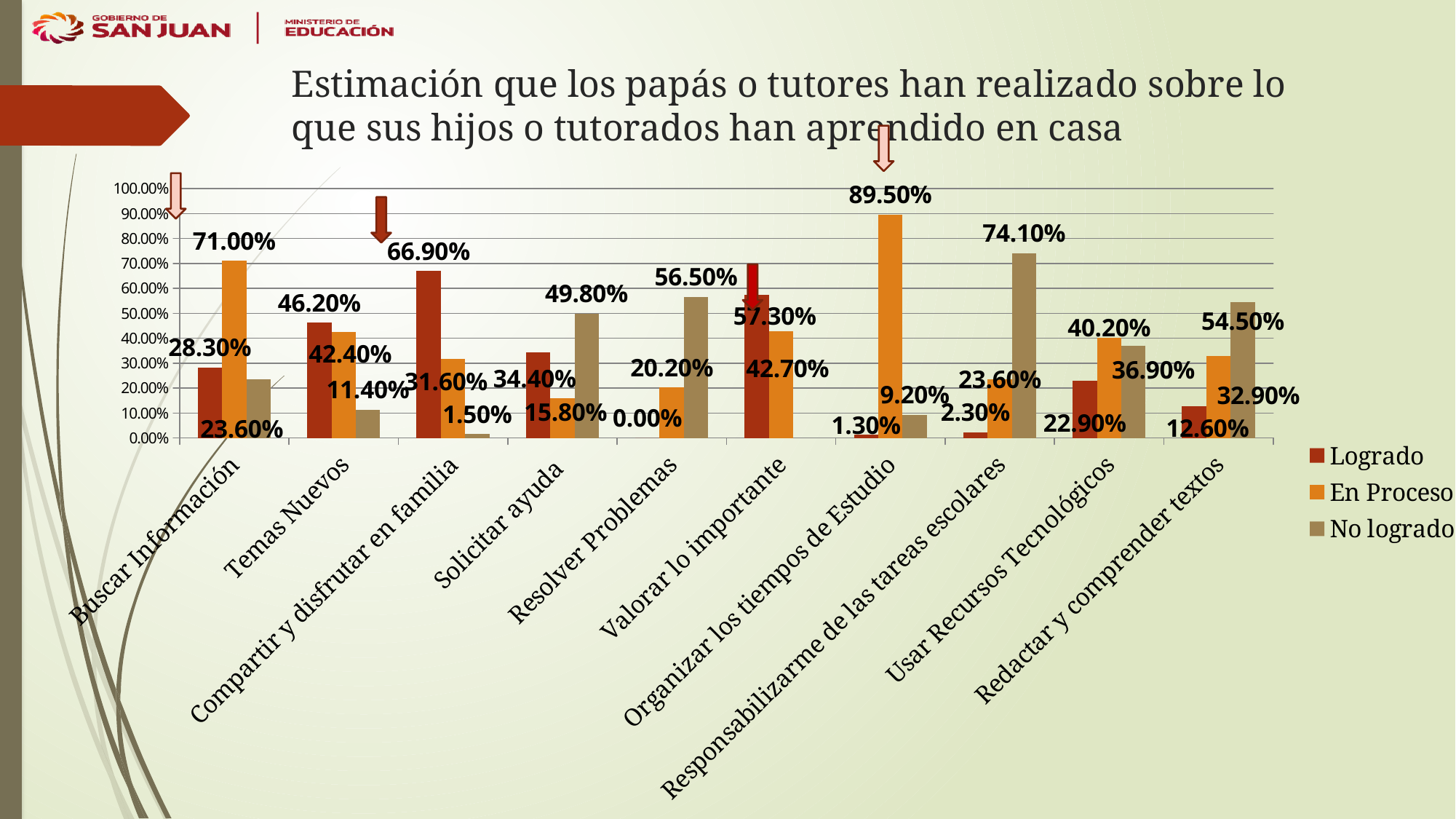
Which category has the highest En Proceso value? Organizar los tiempos de Estudio How many categories are shown on the x axis? 10 What is the Logrado value for Compartir y disfrutar en familia? 66.90% For Solicitar ayuda, which is larger: Logrado or No logrado? No logrado Which category has the highest Logrado value? Compartir y disfrutar en familia What are the three series listed in the legend? Logrado, En Proceso, No logrado What kind of chart is shown on the slide? Bar chart How many series does the legend list? 3 What is the No logrado value for Responsabilizarme de las tareas escolares? 74.10% What is the En Proceso value for Organizar los tiempos de Estudio? 89.50% What is the En Proceso value for Usar Recursos Tecnológicos? 40.20% For Temas Nuevos, what is the difference between the Logrado and En Proceso values? 3.80%